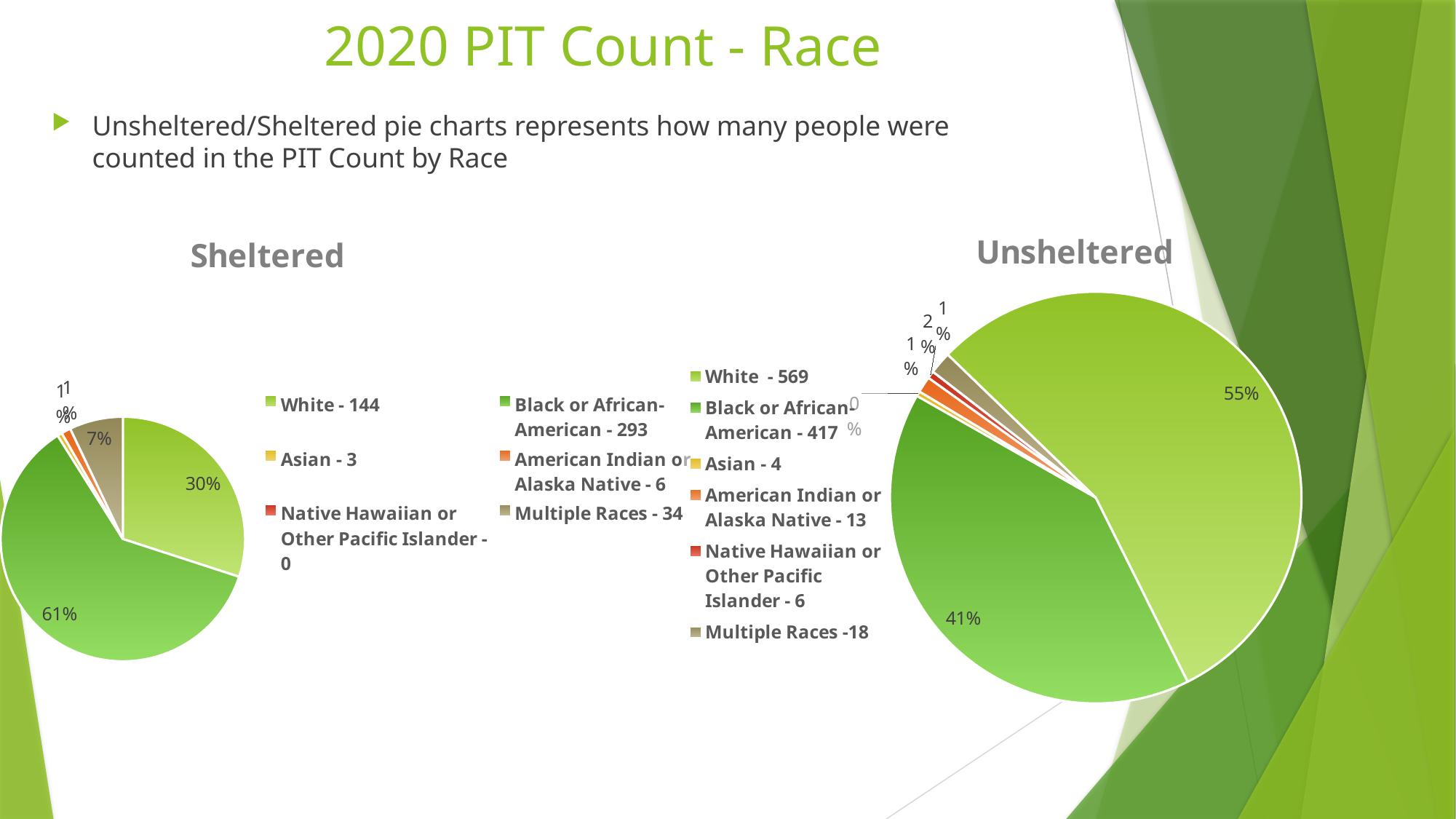
In the Unsheltered chart, what is the difference between the White count (569) and the Black or African-American count (417) shown in the legend? 152 In the Sheltered chart, what share of the pie is White? 30% In the Unsheltered chart, what share of the pie is White? 55% In the Sheltered chart, which race has the largest slice? Black or African-American In the Unsheltered chart, how many people are listed in the legend for Black or African-American? 417 In the Sheltered chart, what share of the pie is Multiple Races? 7% How many race categories does the legend of the Unsheltered chart list? 6 In the Sheltered chart, how many people are listed in the legend for Multiple Races? 34 What kind of chart is the Sheltered chart? pie chart In the Unsheltered chart, which race has the largest slice? White